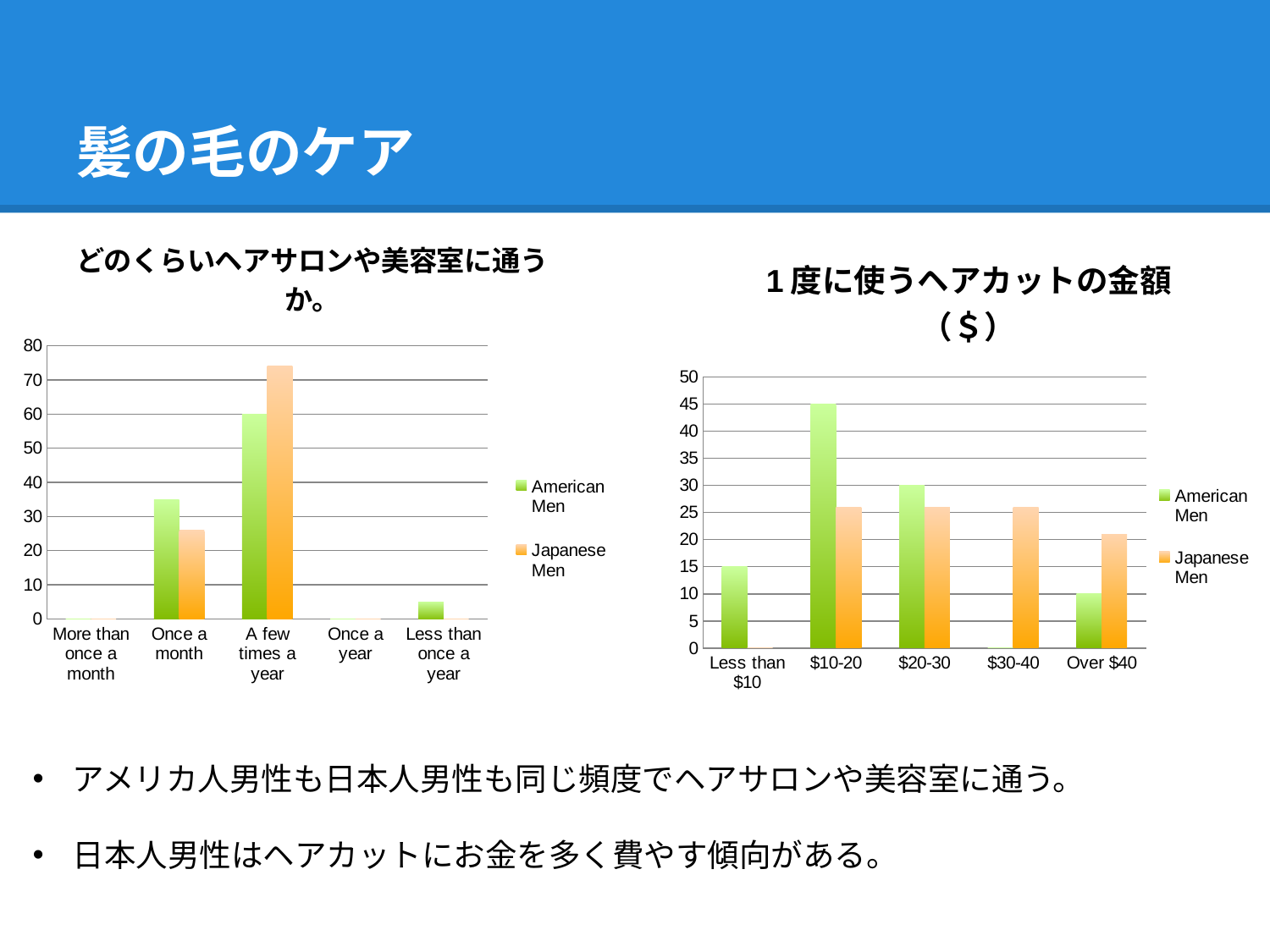
In the left chart titled 'どのくらいヘアサロンや美容室に通うか。', which is larger in the 'A few times a year' category, American Men or Japanese Men? Japanese Men In the right chart titled '1度に使うヘアカットの金額（$）', which is larger in the $10-20 category, American Men or Japanese Men? American Men In the left chart titled 'どのくらいヘアサロンや美容室に通うか。', is the value for Japanese Men in the 'A few times a year' category greater or less than 70? greater In the right chart titled '1度に使うヘアカットの金額（$）', how many price categories are shown on the x axis? 5 In the left chart titled 'どのくらいヘアサロンや美容室に通うか。', is the value for Japanese Men in the 'Once a month' category greater or less than 30? less In the right chart titled '1度に使うヘアカットの金額（$）', which category has the highest value for American Men? $10-20 What kind of chart is the left chart titled 'どのくらいヘアサロンや美容室に通うか。'? bar chart In the right chart titled '1度に使うヘアカットの金額（$）', is the value for Japanese Men in the Over $40 category greater or less than 25? less In the left chart titled 'どのくらいヘアサロンや美容室に通うか。', what are the two legend entries? American Men, Japanese Men In the right chart titled '1度に使うヘアカットの金額（$）', what is the value for American Men in the $20-30 category? 30 In the right chart titled '1度に使うヘアカットの金額（$）', how many series does the legend list? 2 In the right chart titled '1度に使うヘアカットの金額（$）', what is the value for American Men in the $10-20 category? 45